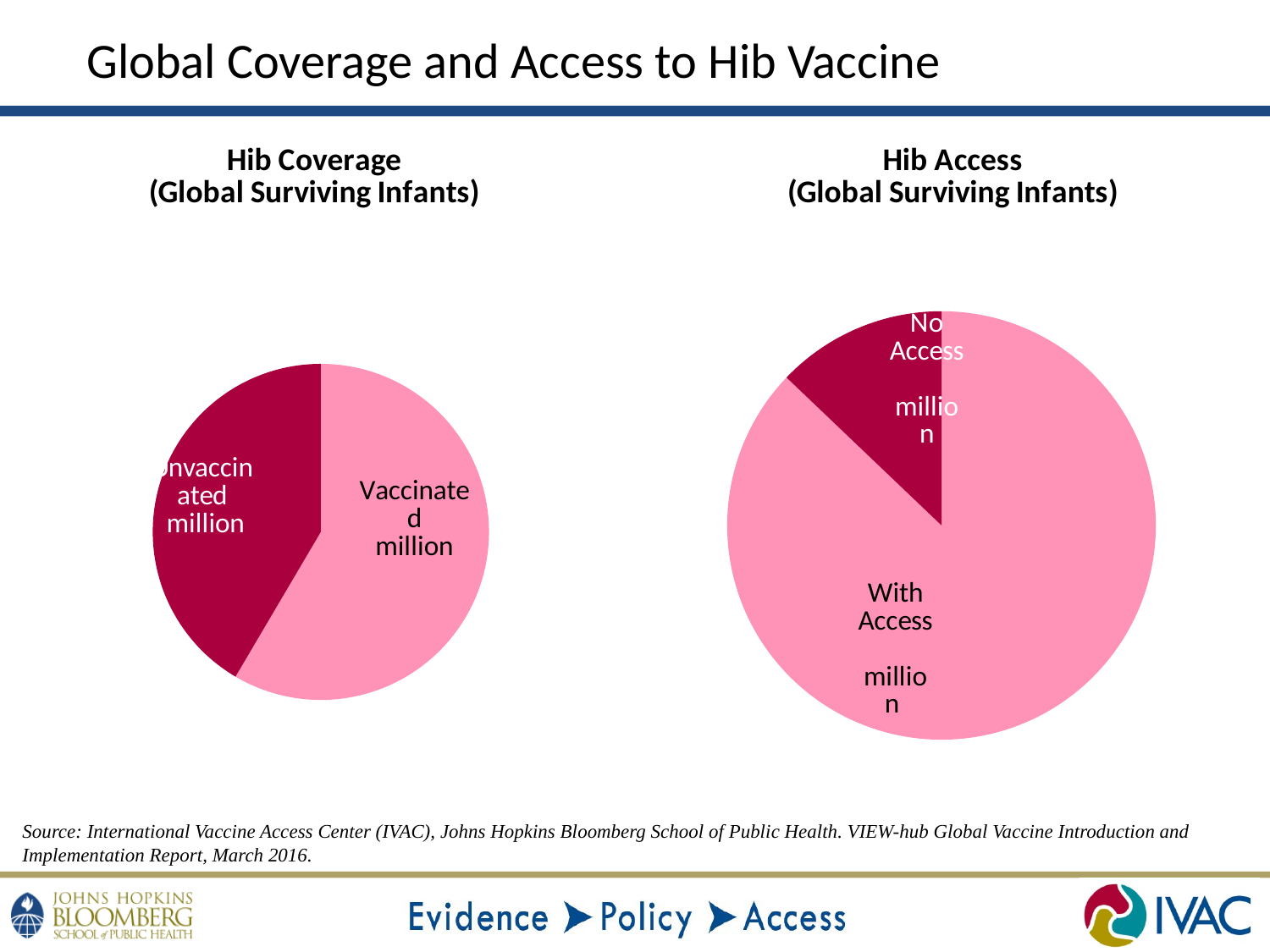
In the Hib Access (Global Surviving Infants) chart, which slice is the largest? With Access What kind of chart is the Hib Coverage (Global Surviving Infants) chart on the left? Pie chart In the Hib Access (Global Surviving Infants) chart, which slice is the smallest? No Access In the Hib Coverage (Global Surviving Infants) chart, which slice is the smallest? Unvaccinated How many slices does the Hib Access (Global Surviving Infants) pie chart have? 2 How many slices does the Hib Coverage (Global Surviving Infants) pie chart have? 2 In the Hib Access (Global Surviving Infants) chart, which is larger: the With Access slice or the No Access slice? With Access In the Hib Coverage (Global Surviving Infants) chart, which slice is the largest? Vaccinated In the Hib Coverage (Global Surviving Infants) chart, which is larger: the Vaccinated slice or the Unvaccinated slice? Vaccinated What is the title of the pie chart on the right of the slide? Hib Access (Global Surviving Infants) What kind of chart is the Hib Access (Global Surviving Infants) chart on the right? Pie chart In the Hib Coverage (Global Surviving Infants) chart, what colour is the Unvaccinated slice? Dark red